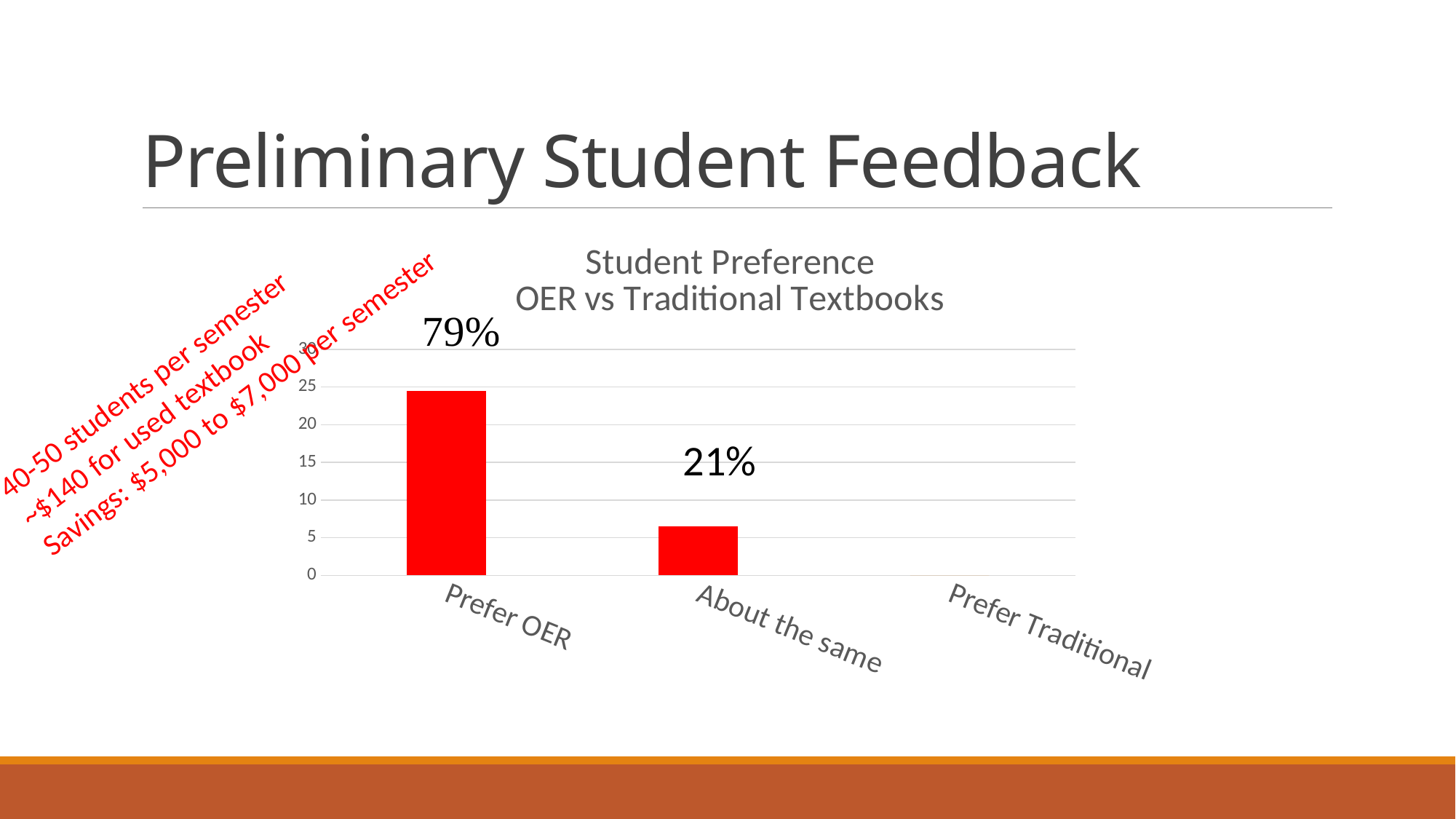
Is the value for Prefer OER greater or less than 20? greater What is the title of the chart? Student Preference OER vs Traditional Textbooks What kind of chart is shown on the slide? bar chart What colour are the bars in the chart? red Which category has the highest bar? Prefer OER Do the bar values rise or fall from left to right along the x axis? fall How many categories are shown on the x axis of the chart? 3 What percentage label is shown above the Prefer OER bar? 79% Is the value for About the same greater or less than 10? less Which is larger, the bar for Prefer OER or the bar for About the same? Prefer OER What percentage label is shown above the About the same bar? 21% Which category has the lowest bar? Prefer Traditional